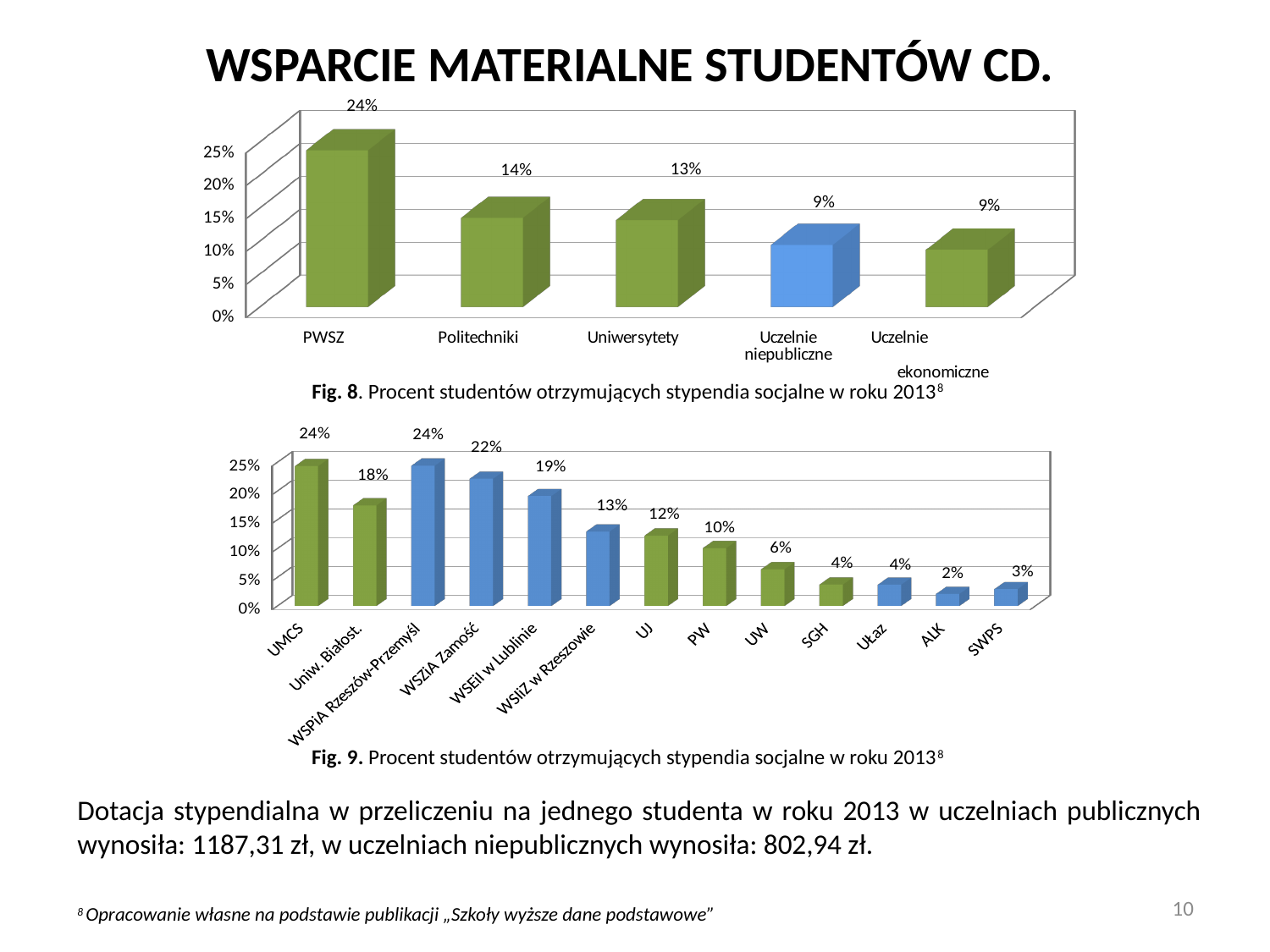
In the top chart (Fig. 8), which category has the highest value? PWSZ In the bottom chart (Fig. 9), how many categories are shown? 13 In the top chart (Fig. 8), what is the value for PWSZ? 24% In the top chart (Fig. 8), how many categories are shown? 5 In the bottom chart (Fig. 9), what is the value for UJ? 12% In the bottom chart (Fig. 9), which category has the lowest value? ALK In the top chart (Fig. 8), what is the value for Politechniki? 14% In the top chart (Fig. 8), what is the difference between the values for PWSZ and Uniwersytety? 11% In the bottom chart (Fig. 9), which is larger, the value for Uniw. Białost. or the value for PW? Uniw. Białost. In the bottom chart (Fig. 9), what is the value for WSZiA Zamość? 22% In the bottom chart (Fig. 9), what is the difference between the values for UMCS and UW? 18% In the top chart (Fig. 8), what kind of chart is it? bar chart